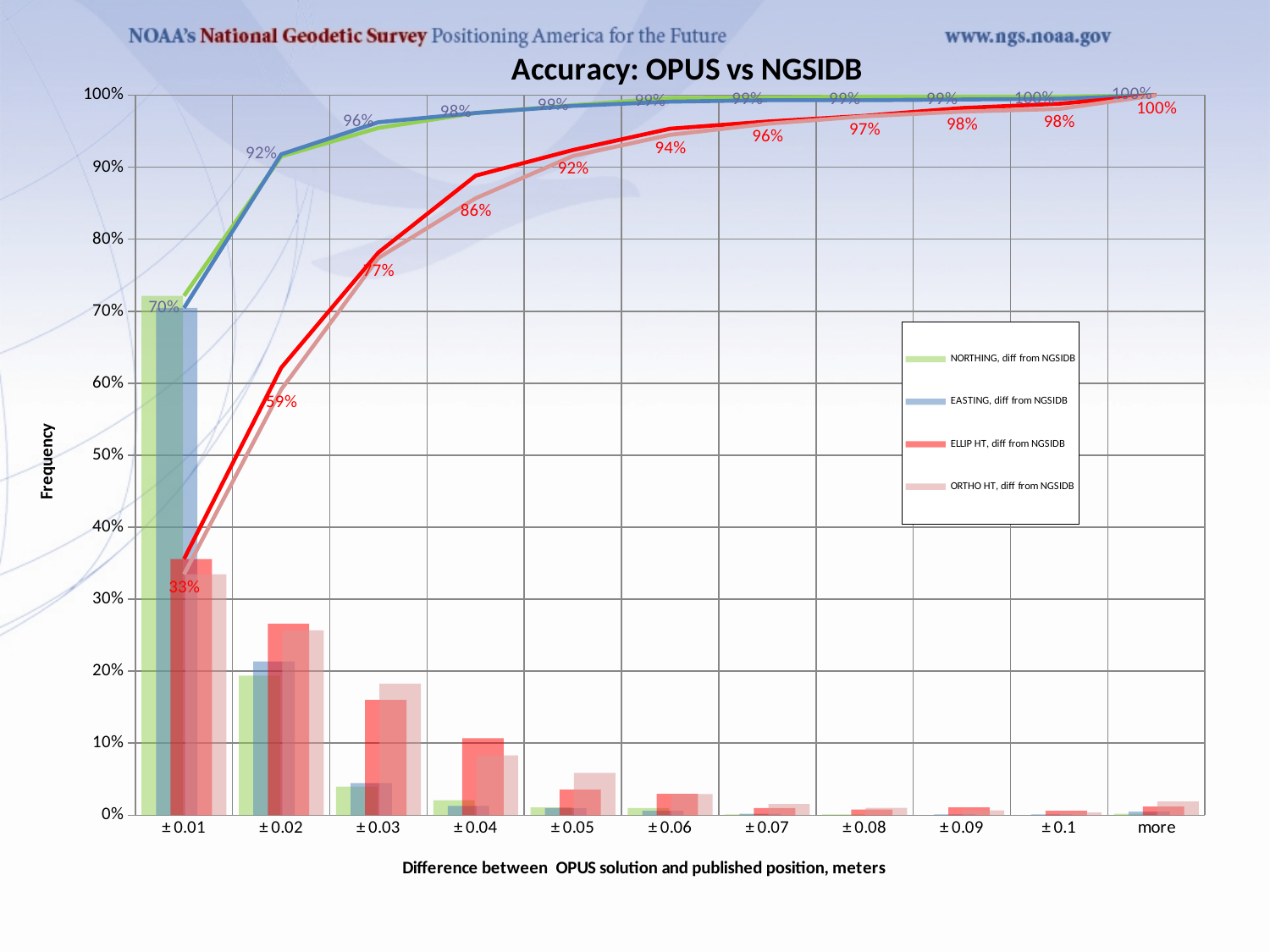
What cumulative percentage is labelled in red at ±0.06? 94% How many series does the legend list? 4 What is the difference between the red cumulative labels at ±0.02 (59%) and ±0.01 (33%)? 26 percentage points What cumulative percentage is labelled in red at ±0.08? 97% What is the title of the chart? Accuracy: OPUS vs NGSIDB How many categories are shown on the x axis? 11 Which x-axis category has the tallest bars? ±0.01 At ±0.01, which bar is taller: NORTHING (green) or ELLIP HT (red)? NORTHING Is the NORTHING bar at ±0.01 greater or less than 60%? greater Do the cumulative lines rise or fall as the x axis moves from ±0.01 to more? rise What cumulative percentage is labelled in blue at ±0.02? 92% What cumulative percentage is labelled in red at ±0.04? 86%